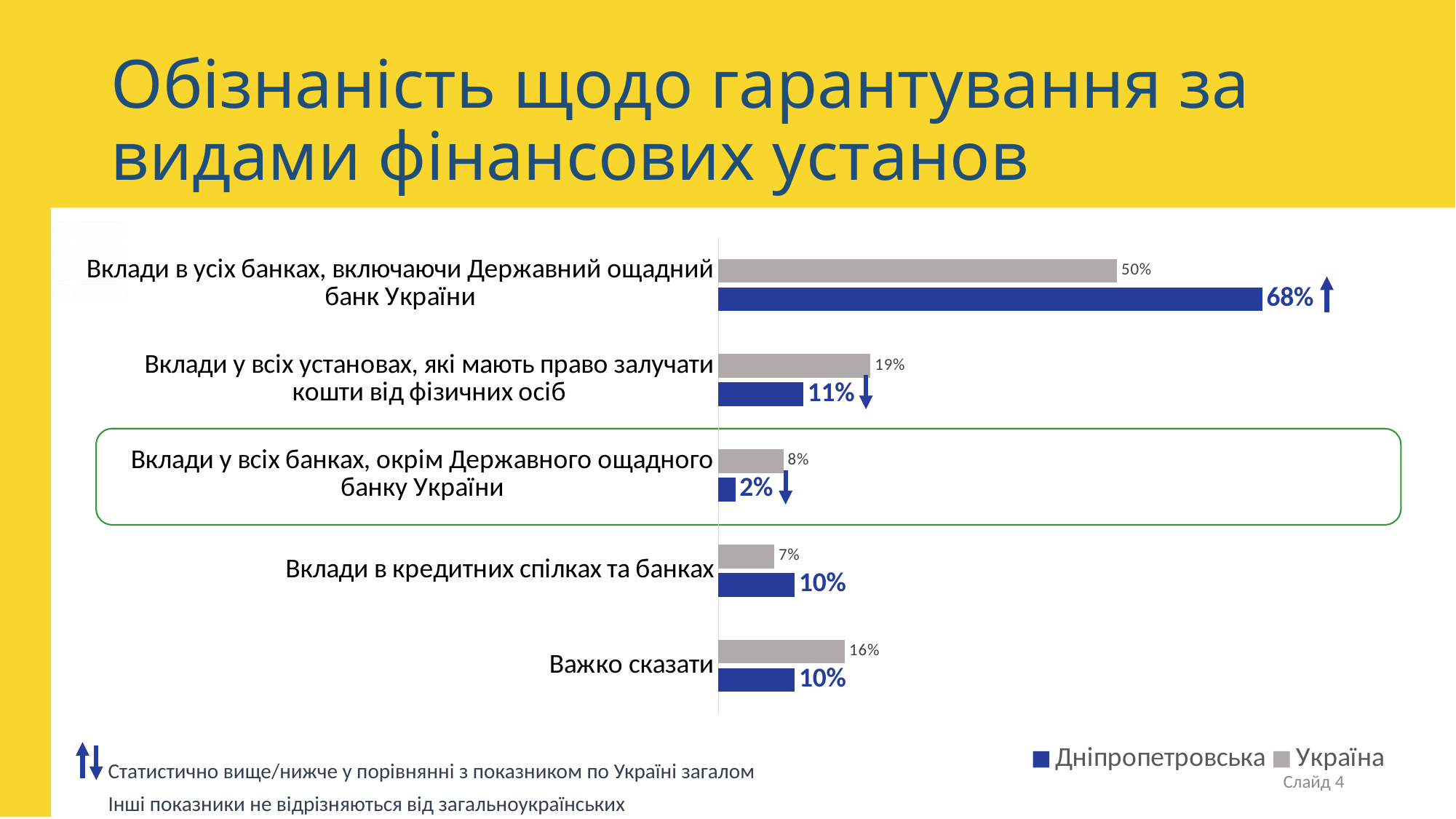
What is the value for Дніпропетровська for "Вклади у всіх банках, окрім Державного ощадного банку України"? 2% What is the value for Україна for "Важко сказати"? 16% What is the difference between the Дніпропетровська and Україна values for "Вклади в усіх банках, включаючи Державний ощадний банк України"? 18% For "Вклади в кредитних спілках та банках", which is larger: the Дніпропетровська value or the Україна value? Дніпропетровська Which category has the highest value for Дніпропетровська? Вклади в усіх банках, включаючи Державний ощадний банк України Which series is shown in blue in the legend? Дніпропетровська How many series does the legend list? 2 What is the value for Дніпропетровська for "Вклади в усіх банках, включаючи Державний ощадний банк України"? 68% How many categories are shown in the chart? 5 What type of chart is shown on the slide? bar chart Which category has the lowest value for Україна? Вклади в кредитних спілках та банках What is the value for Україна for "Вклади у всіх установах, які мають право залучати кошти від фізичних осіб"? 19%